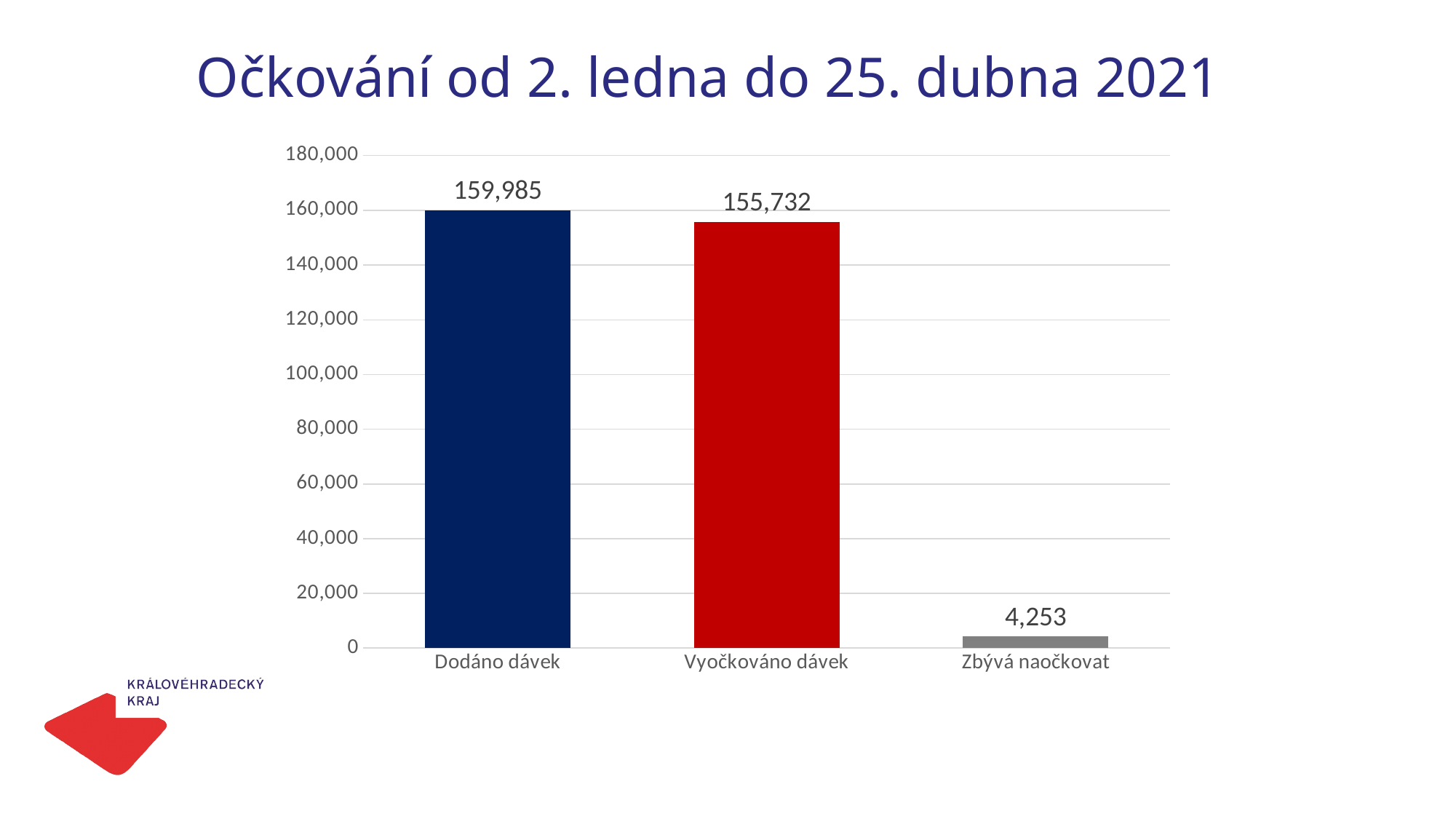
What is the difference between Dodáno dávek and Vyočkováno dávek? 4,253 Is the value for Zbývá naočkovat greater or less than 20,000? less What is the value for Zbývá naočkovat? 4,253 What is the value for Vyočkováno dávek? 155,732 Which category has the lowest value? Zbývá naočkovat Which category has the highest value? Dodáno dávek Is the value for Vyočkováno dávek greater or less than 140,000? greater What is the title of the chart? Očkování od 2. ledna do 25. dubna 2021 Which is larger, Vyočkováno dávek or Zbývá naočkovat? Vyočkováno dávek What kind of chart is shown on the slide? bar chart What is the value for Dodáno dávek? 159,985 How many categories are shown in the chart? 3